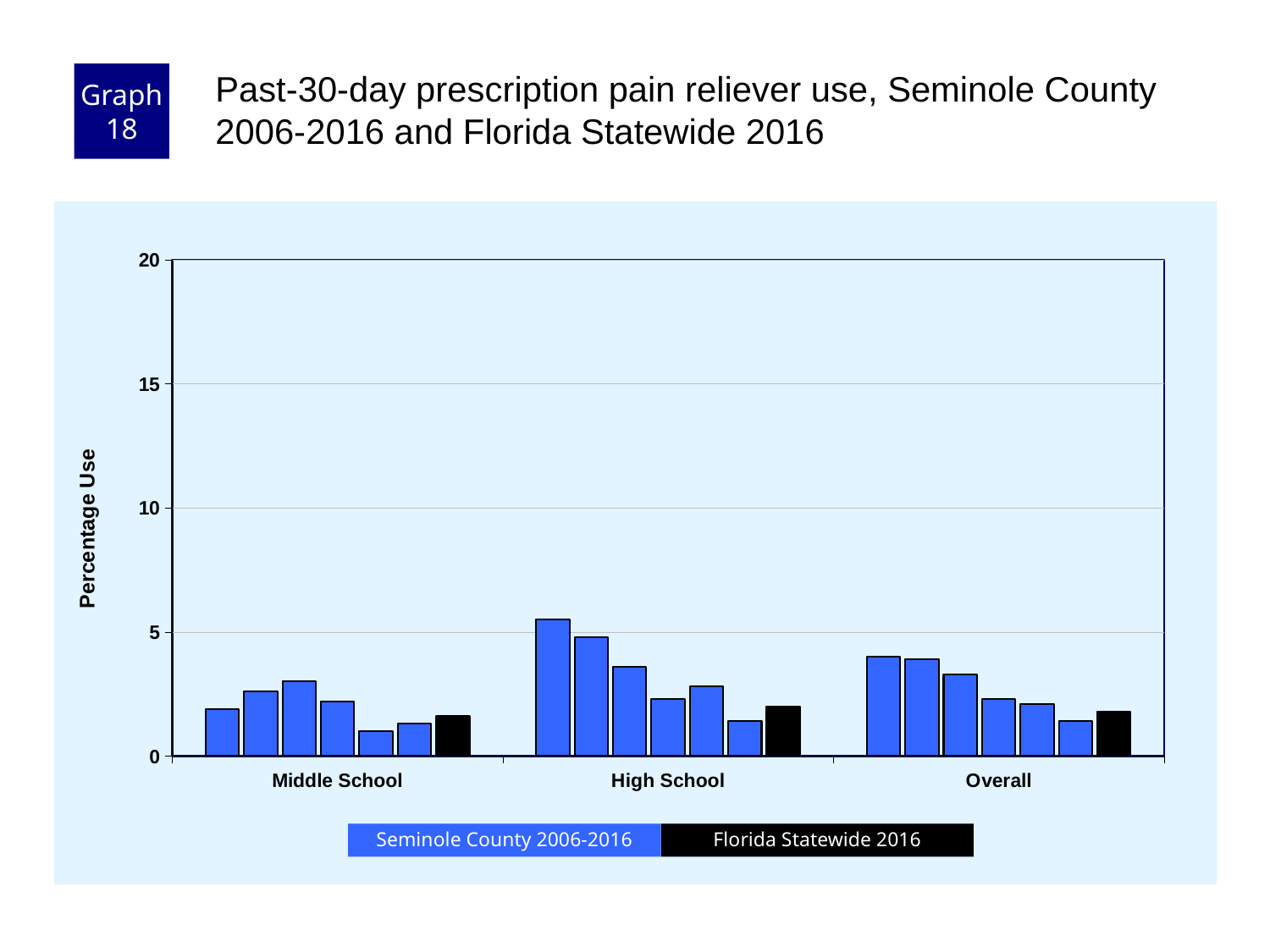
How many categories are shown on the x axis? 3 Are any bars in the Overall group greater than 10? no What kind of chart is shown on the slide? bar chart Which category has the highest Florida Statewide 2016 value? High School What colour represents Florida Statewide 2016 in the legend? black Which category group contains the tallest bar on the chart? High School How many series does the legend list? 2 What is the label on the y axis? Percentage Use Is the value for the Florida Statewide 2016 bar in the Middle School group greater or less than 5? less Is the value for the Florida Statewide 2016 bar in the High School group greater or less than 5? less Do the Seminole County 2006-2016 bars in the High School group generally rise or fall from left to right? fall